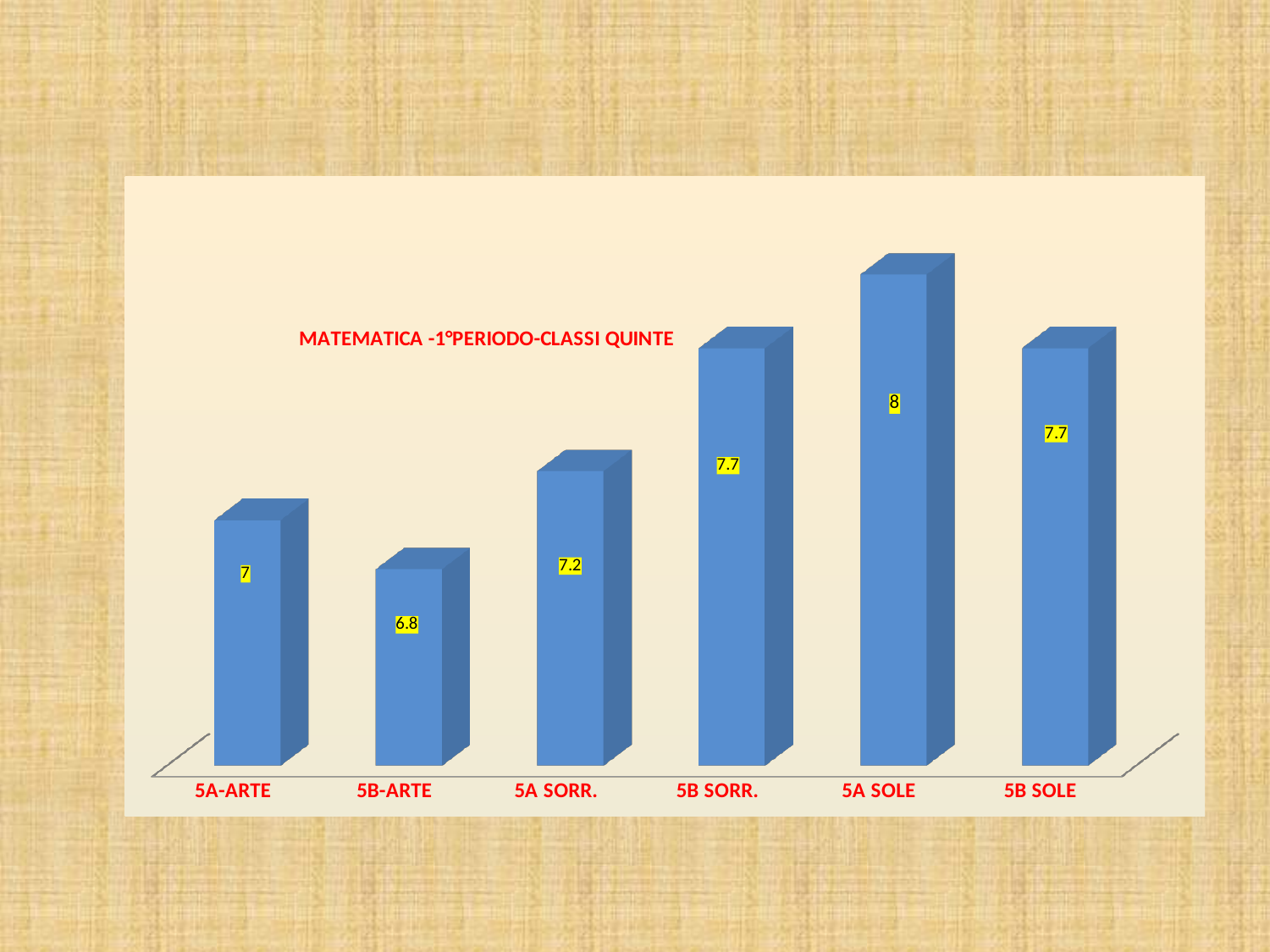
Which category has the highest value? 5A SOLE What is the difference between the values for 5A SOLE and 5B-ARTE? 1.2 What is the value for 5B-ARTE? 6.8 What is the value for 5A-ARTE? 7 Which is larger, the value for 5A SORR. or the value for 5B SORR.? 5B SORR. What is the value for 5A SOLE? 8 What kind of chart is shown on the slide? Bar chart What is the difference between the values for 5B SORR. and 5A SORR.? 0.5 How many categories are shown on the x axis? 6 Which category has the lowest value? 5B-ARTE What is the value for 5A SORR.? 7.2 What is the title of the chart? MATEMATICA -1°PERIODO-CLASSI QUINTE